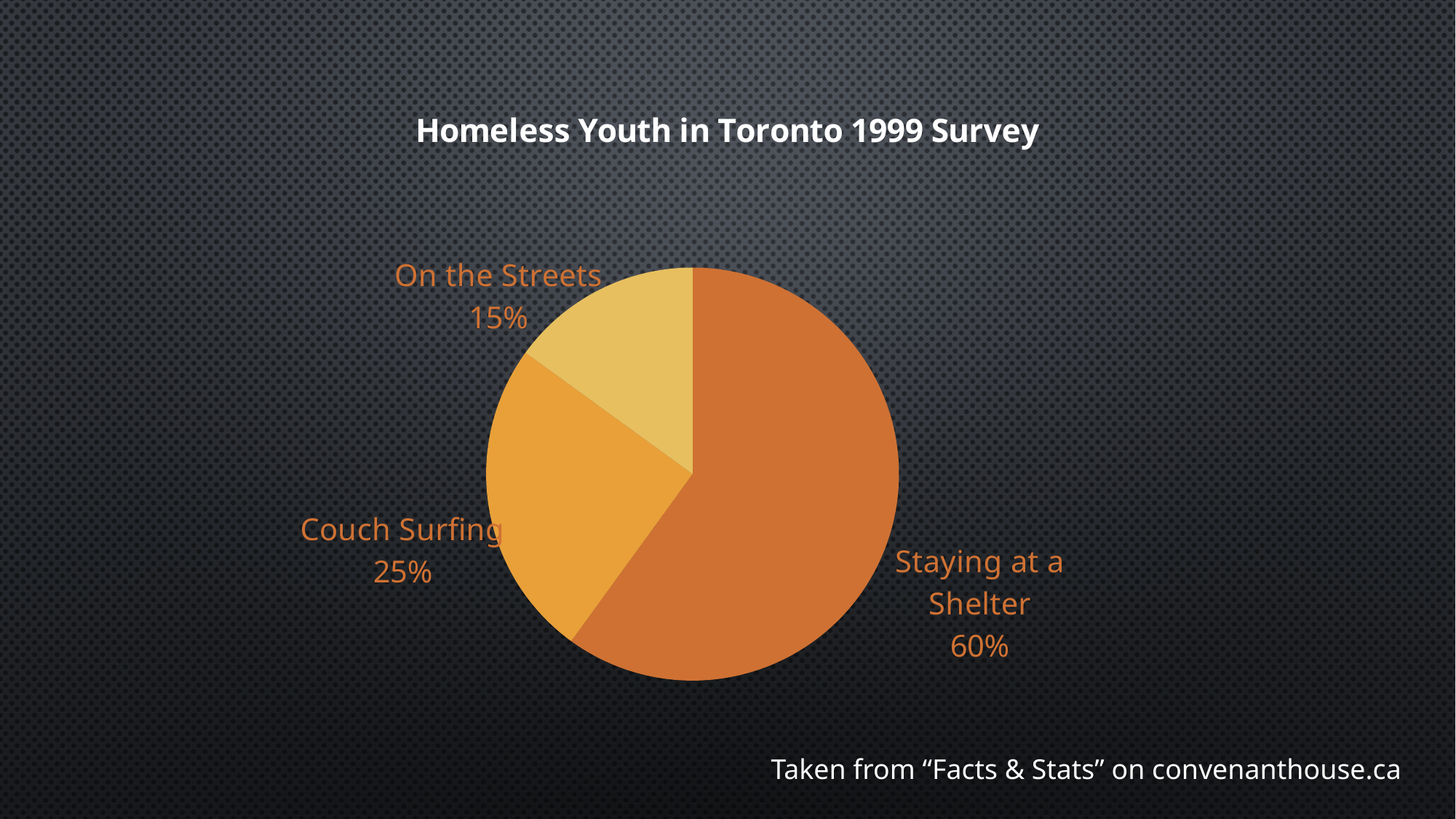
What percentage of homeless youth were on the streets? 15% Which is larger, Couch Surfing or On the Streets? Couch Surfing How many categories are shown in the pie chart? 3 Which category has the largest share of the pie? Staying at a Shelter Which category has the smallest share of the pie? On the Streets What percentage of homeless youth were staying at a shelter? 60% What kind of chart is shown on the slide? Pie chart What is the difference in percentage points between Couch Surfing and On the Streets? 10 What is the difference in percentage points between Staying at a Shelter and Couch Surfing? 35 What is the title of the chart? Homeless Youth in Toronto 1999 Survey What percentage of homeless youth were couch surfing? 25% What is the combined share of Couch Surfing and On the Streets? 40%